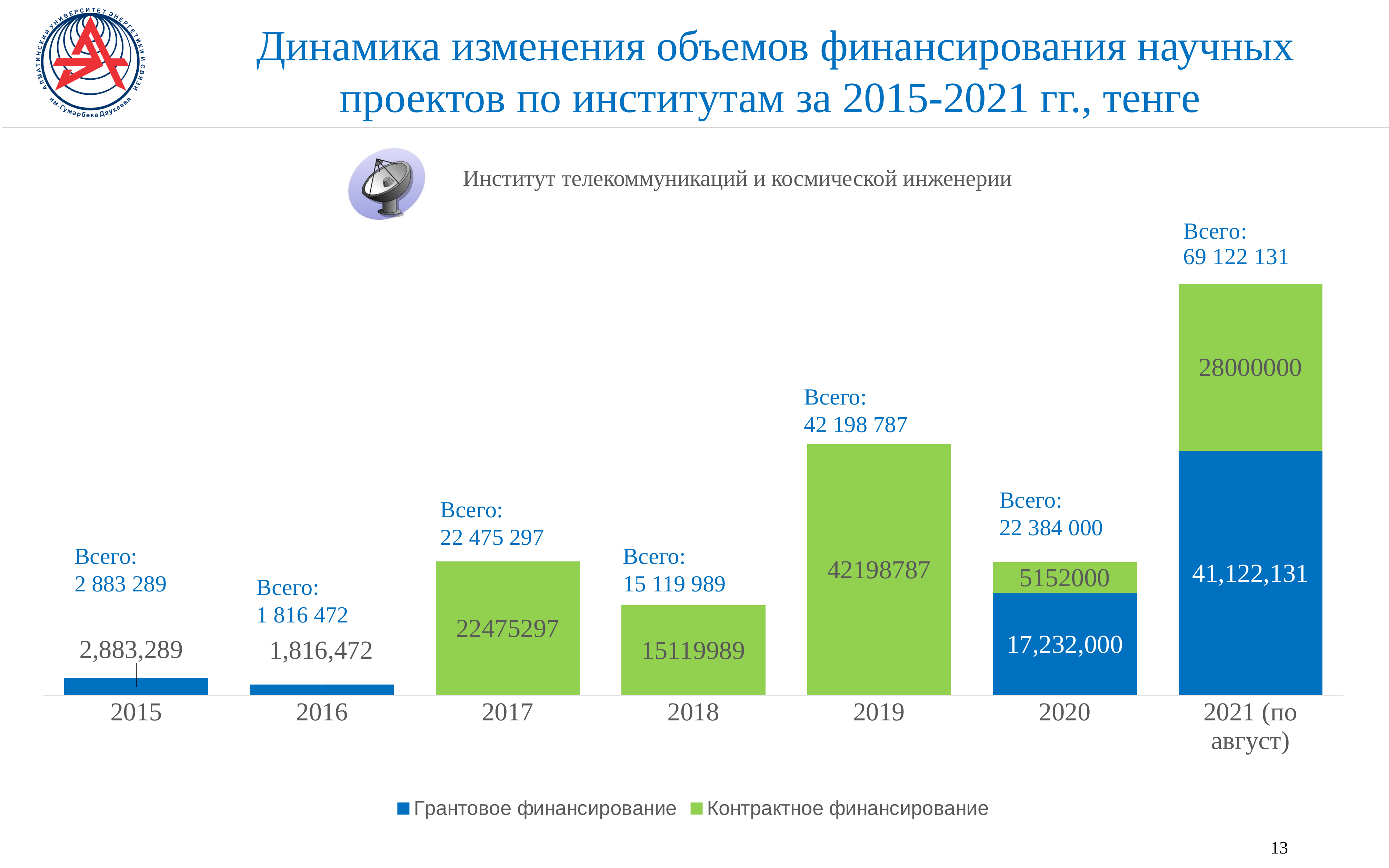
How many year categories are shown on the x axis? 7 What is the value of Контрактное финансирование for 2021 (по август)? 28000000 What type of chart is shown on the slide? Stacked bar chart What is the total (Всего) for 2021 (по август)? 69 122 131 Which year has the highest total funding? 2021 (по август) Which is larger: the total for 2017 or the total for 2018? 2017 What is the value of Контрактное финансирование for 2019? 42198787 What is the value of Грантовое финансирование for 2015? 2,883,289 Which year has the lowest total funding? 2016 How many series does the legend list? 2 What is the value of Грантовое финансирование for 2020? 17,232,000 What is the difference between the Грантовое финансирование values for 2015 and 2016? 1,066,817